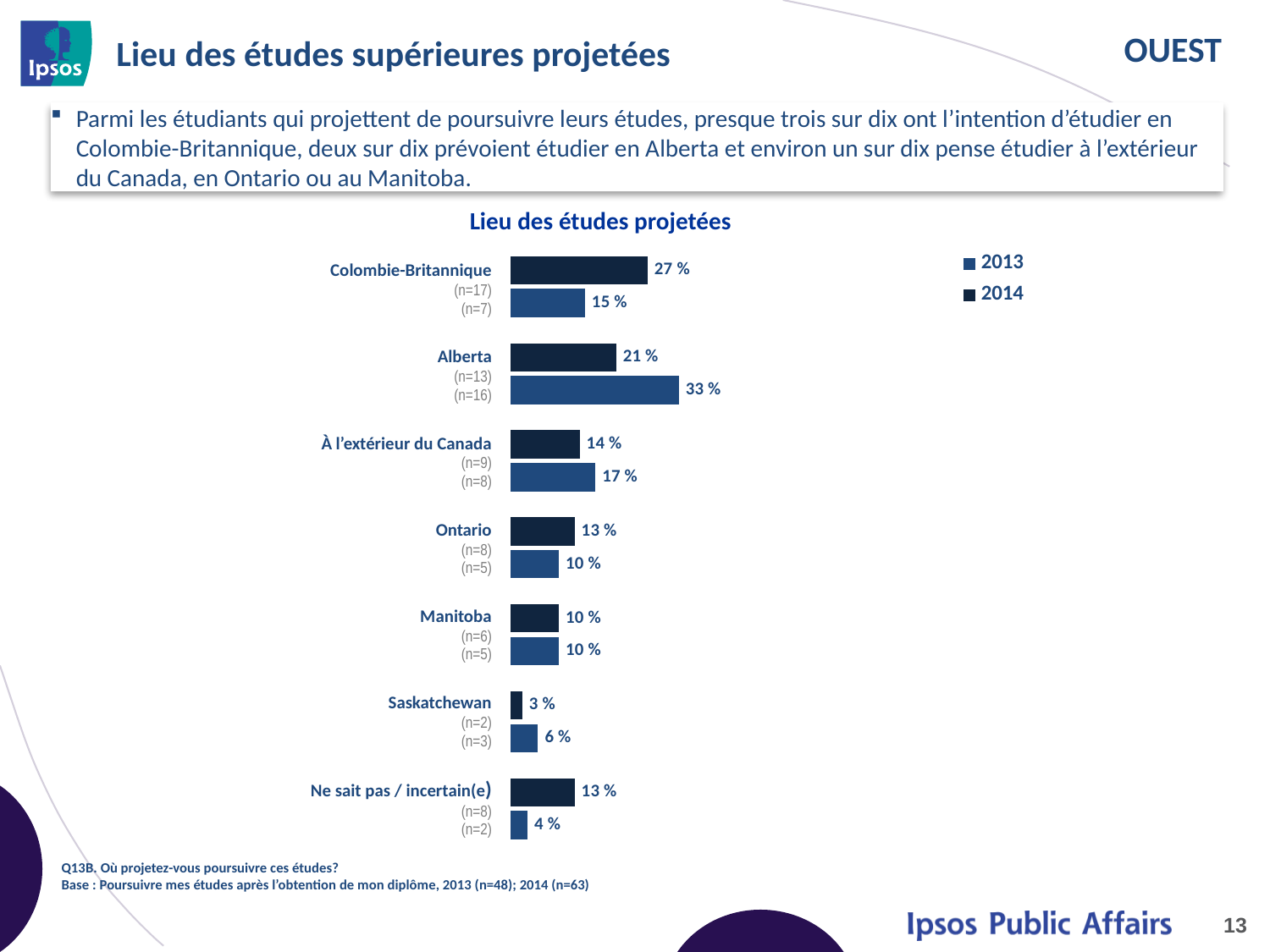
What is the title of the chart? Lieu des études projetées Which category has the lowest 2013 value? Ne sait pas / incertain(e) How many series does the legend list? 2 What is the 2013 value for Colombie-Britannique? 15 % For Colombie-Britannique, which year has the larger value, 2013 or 2014? 2014 What is the 2014 value for Alberta? 21 % What is the 2014 value for Ne sait pas / incertain(e)? 13 % Which category has the highest 2014 value? Colombie-Britannique What is the difference between the 2014 and 2013 values for Alberta? 12 % How many categories are shown on the chart? 7 What is the 2013 value for À l'extérieur du Canada? 17 % What kind of chart is shown on the slide? Bar chart